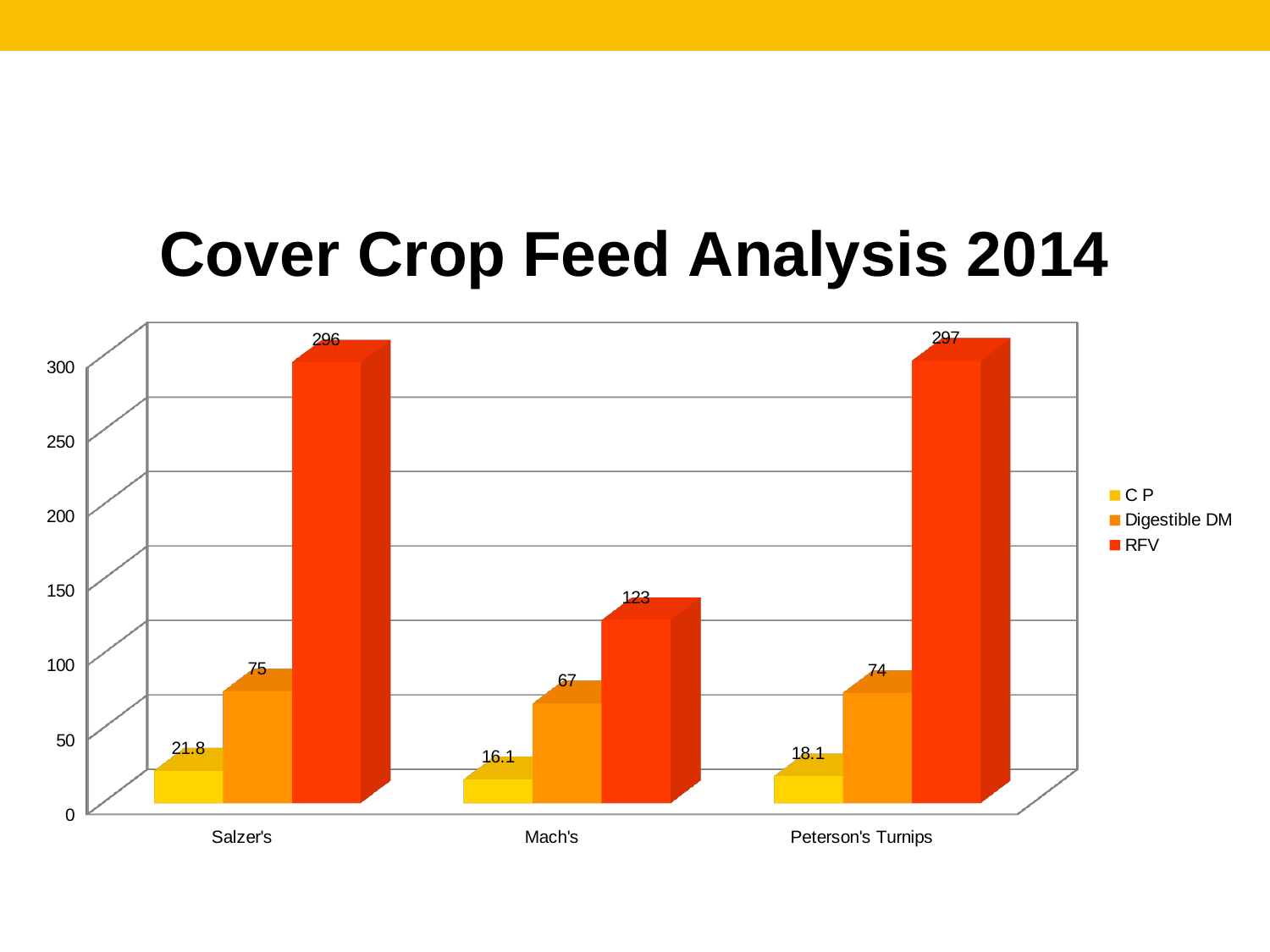
Which is larger, the Digestible DM value for Salzer's or for Mach's? Salzer's How many series does the legend list? 3 How many categories are shown on the x axis? 3 What is the Digestible DM value for Peterson's Turnips? 74 What kind of chart is shown on the slide? Bar chart What is the RFV value for Salzer's? 296 What is the C P value for Mach's? 16.1 What is the title of the chart? Cover Crop Feed Analysis 2014 What is the difference between the C P values for Salzer's and Peterson's Turnips? 3.7 Which category has the highest C P value? Salzer's What is the difference between the RFV values for Salzer's and Mach's? 173 Which category has the lowest RFV value? Mach's